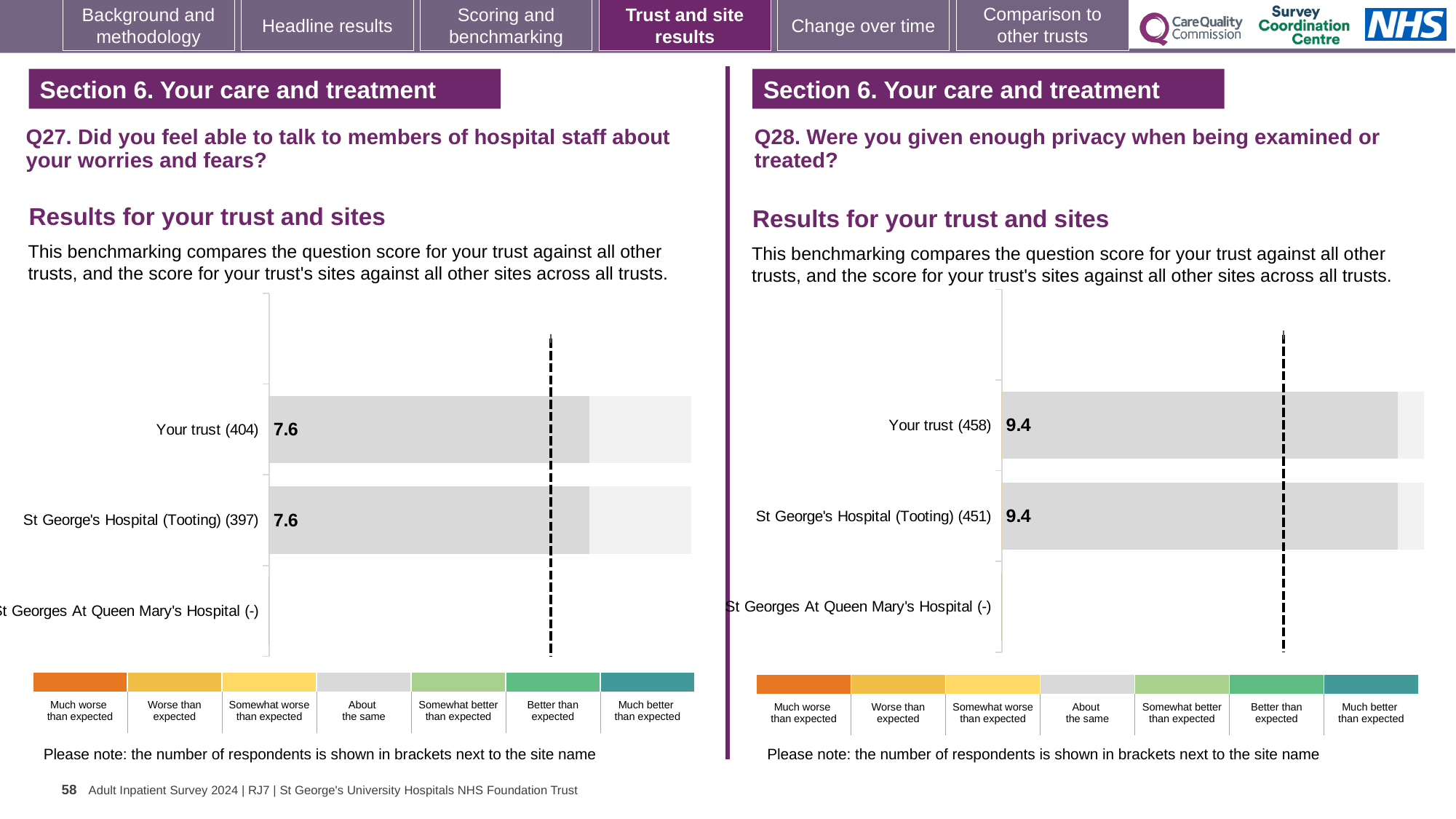
In the Q28 chart on the right, what is the score for Your trust (458)? 9.4 In the Q27 chart on the left, how many respondents are shown in brackets for Your trust? 404 In the Q27 chart on the left, what is the score for Your trust (404)? 7.6 What kind of chart is used for the Q27 results on the left? Bar chart In the Q28 chart on the right, what is the difference between the score for Your trust and the score for St George's Hospital (Tooting)? 0 In the Q28 chart on the right, how many respondents are shown in brackets for St George's Hospital (Tooting)? 451 Is the score for Your trust in the Q28 chart on the right larger or smaller than the score for Your trust in the Q27 chart on the left? Larger How many categories are listed on the vertical axis of the Q27 chart on the left? 3 In the Q27 chart on the left, what is the difference between the score for Your trust and the score for St George's Hospital (Tooting)? 0 In the Q27 chart on the left, what is the score for St George's Hospital (Tooting) (397)? 7.6 In the Q28 chart on the right, what is the score for St George's Hospital (Tooting) (451)? 9.4 How many categories are listed on the vertical axis of the Q28 chart on the right? 3